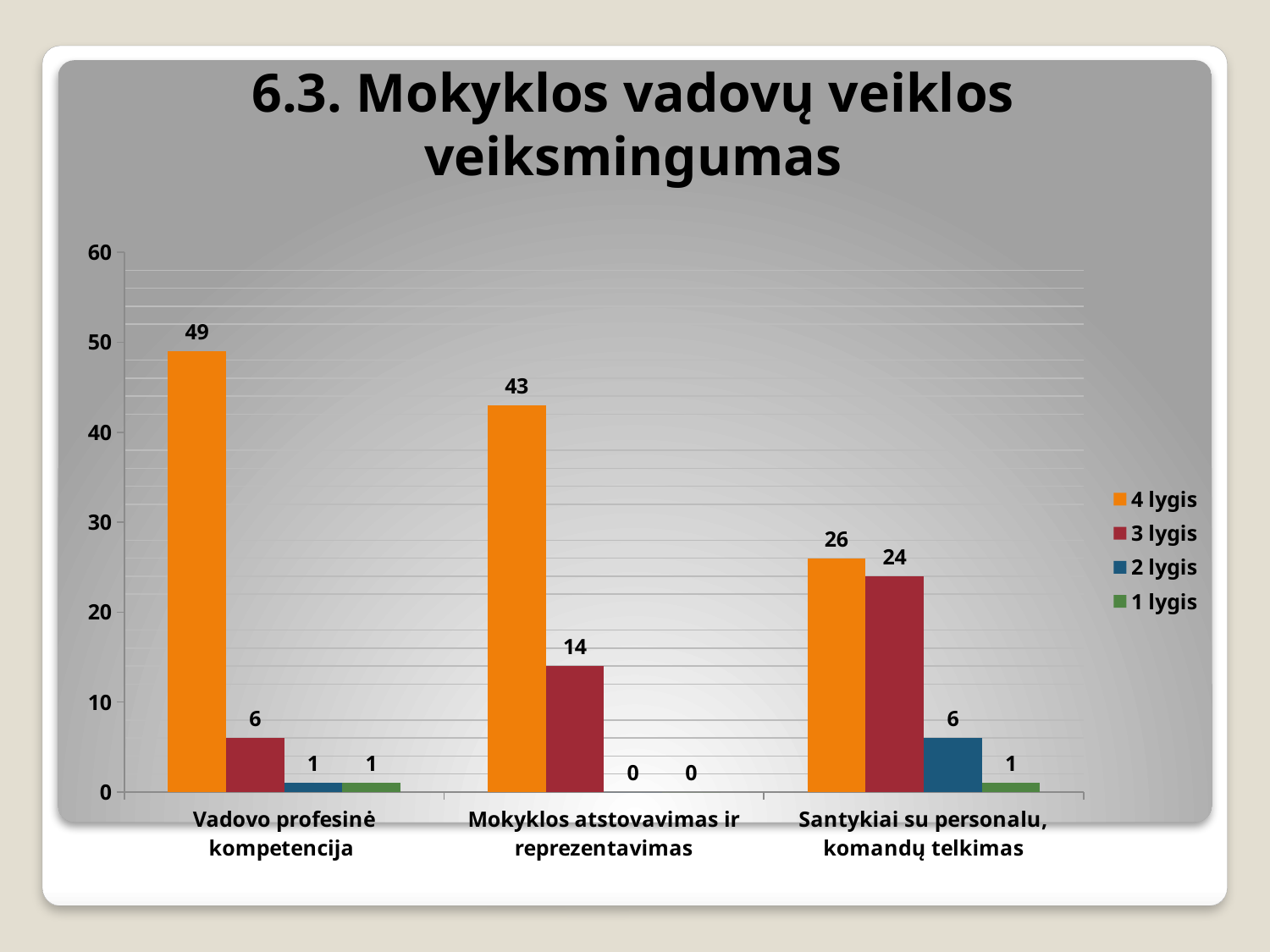
Which category has the highest "4 lygis" value? Vadovo profesinė kompetencija What kind of chart is shown on the slide? Bar chart What is the title of the chart? 6.3. Mokyklos vadovų veiklos veiksmingumas How many categories are shown on the x axis? 3 What is the difference between the "4 lygis" and "3 lygis" values for "Santykiai su personalu, komandų telkimas"? 2 Which is larger: the "4 lygis" value for "Mokyklos atstovavimas ir reprezentavimas" or the "4 lygis" value for "Santykiai su personalu, komandų telkimas"? Mokyklos atstovavimas ir reprezentavimas What is the value of "3 lygis" for "Mokyklos atstovavimas ir reprezentavimas"? 14 What is the value of "2 lygis" for "Santykiai su personalu, komandų telkimas"? 6 Do the "4 lygis" values rise or fall across the categories from left to right? Fall How many series does the legend list? 4 Which category has the lowest "3 lygis" value? Vadovo profesinė kompetencija What is the value of "4 lygis" for "Vadovo profesinė kompetencija"? 49